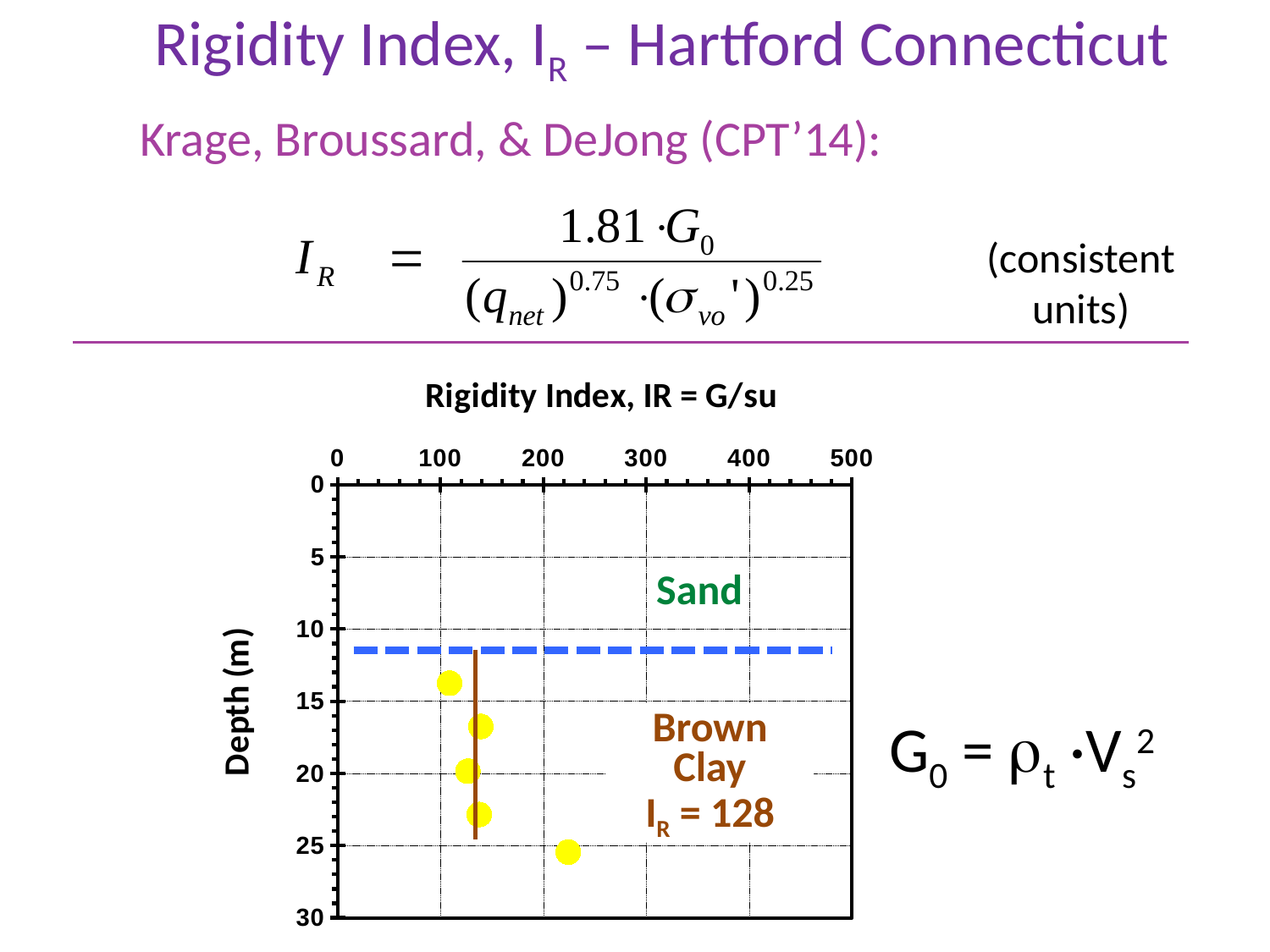
What kind of chart is shown on the slide? scatter chart Which plotted point has the highest rigidity index: the deepest point (about 25 m) or the shallowest point (about 14 m)? the deepest point (about 25 m) What rigidity index value is annotated for the Brown Clay layer on the chart? 128 How many data points are plotted on the chart? 5 What is the maximum value shown on the horizontal (Rigidity Index) axis? 500 At which approximate depth is the point with the lowest rigidity index located: about 14 m or about 25 m? about 14 m Is the rigidity index of the deepest plotted point greater or less than 300? less Is the rigidity index of the deepest plotted point (at about 25 m depth) greater or less than 200? greater What is the maximum depth shown on the vertical axis of the chart? 30 What is the label of the vertical axis of the chart? Depth (m) Is the rigidity index of the shallowest plotted point (at about 14 m depth) greater or less than 200? less